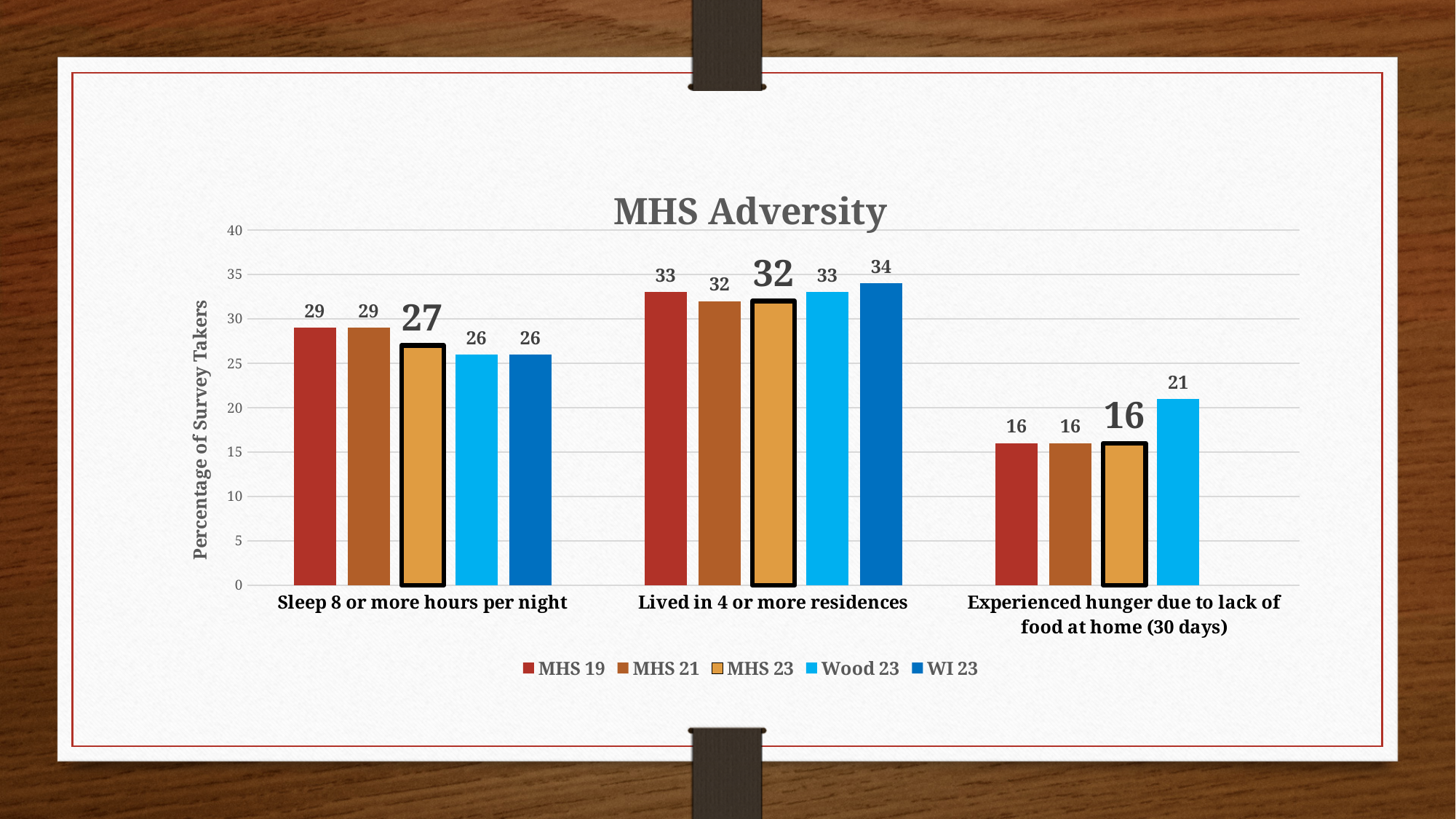
What is the value for MHS 23 in the 'Sleep 8 or more hours per night' category? 27 What is the difference between the Wood 23 and MHS 23 values in the 'Experienced hunger due to lack of food at home (30 days)' category? 5 What is the value for Wood 23 in the 'Experienced hunger due to lack of food at home (30 days)' category? 21 Which series has the highest value in the 'Lived in 4 or more residences' category? WI 23 What is the title of the chart? MHS Adversity What kind of chart is shown on the slide? Bar chart Which is larger: the MHS 21 value for 'Lived in 4 or more residences' or the MHS 21 value for 'Sleep 8 or more hours per night'? Lived in 4 or more residences Which series has the highest value in the 'Experienced hunger due to lack of food at home (30 days)' category? Wood 23 What is the value for WI 23 in the 'Lived in 4 or more residences' category? 34 What is the difference between the MHS 19 and MHS 23 values in the 'Sleep 8 or more hours per night' category? 2 How many series does the legend list? 5 How many categories are shown on the x axis? 3